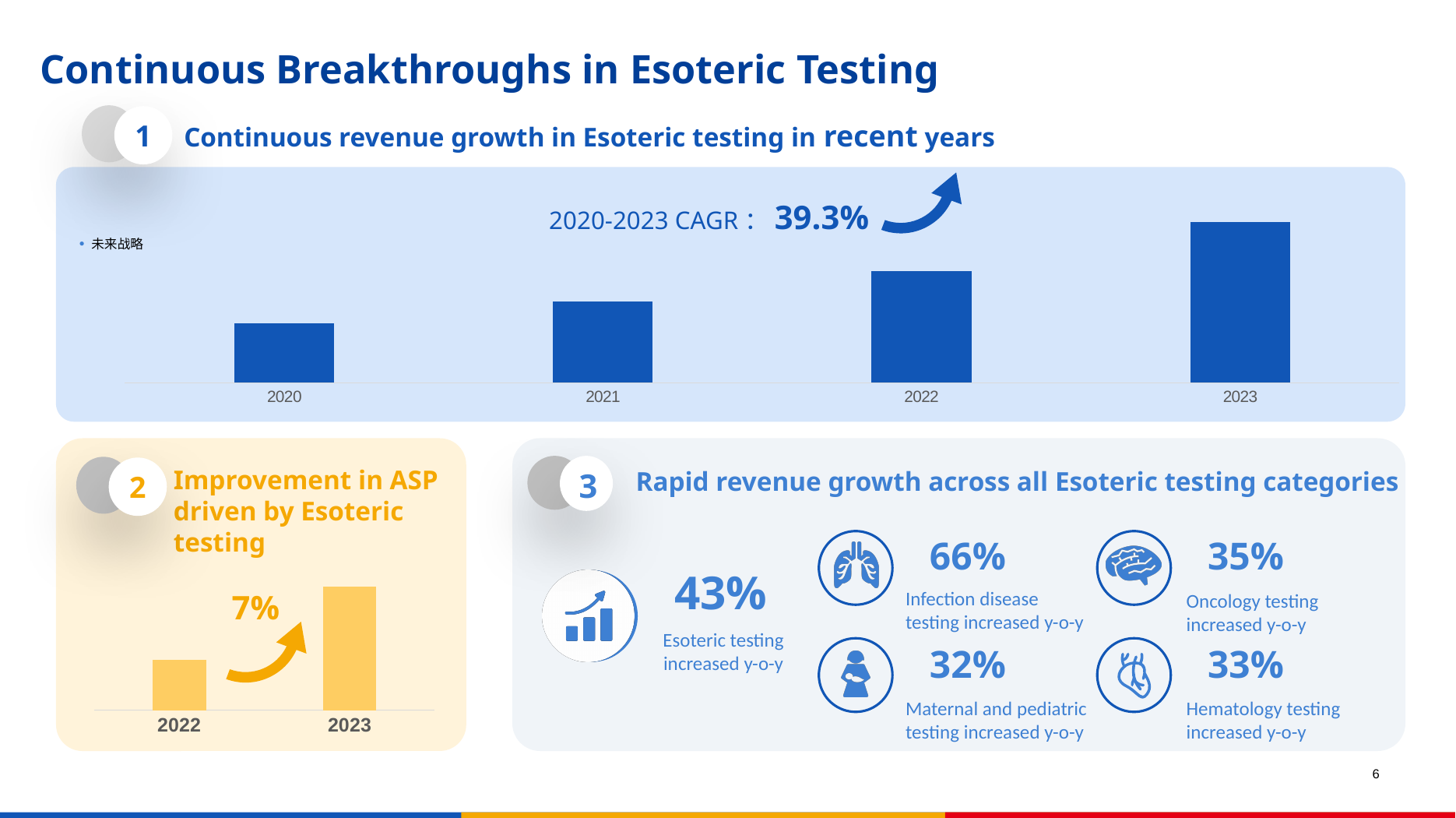
In the top bar chart showing revenue growth in Esoteric testing, which year has the shortest bar? 2020 In the top bar chart, which bar is taller, 2021 or 2022? 2022 In the top bar chart, do the bars rise or fall from 2020 to 2023? rise In the top bar chart showing revenue growth in Esoteric testing, which year has the tallest bar? 2023 How many bars are in the small bar chart in section 2 (Improvement in ASP)? 2 In the small bar chart in section 2 (Improvement in ASP), which year has the taller bar? 2023 How many years are shown on the x axis of the top bar chart? 4 What 2020-2023 CAGR is printed above the top bar chart? 39.3% What kind of chart is shown in section 2 (Improvement in ASP)? bar chart What kind of chart is the top chart showing revenue growth in Esoteric testing? bar chart In the small bar chart in section 2 (Improvement in ASP), does the value rise or fall from 2022 to 2023? rise What percentage is printed between the bars in the small bar chart in section 2 (Improvement in ASP)? 7%